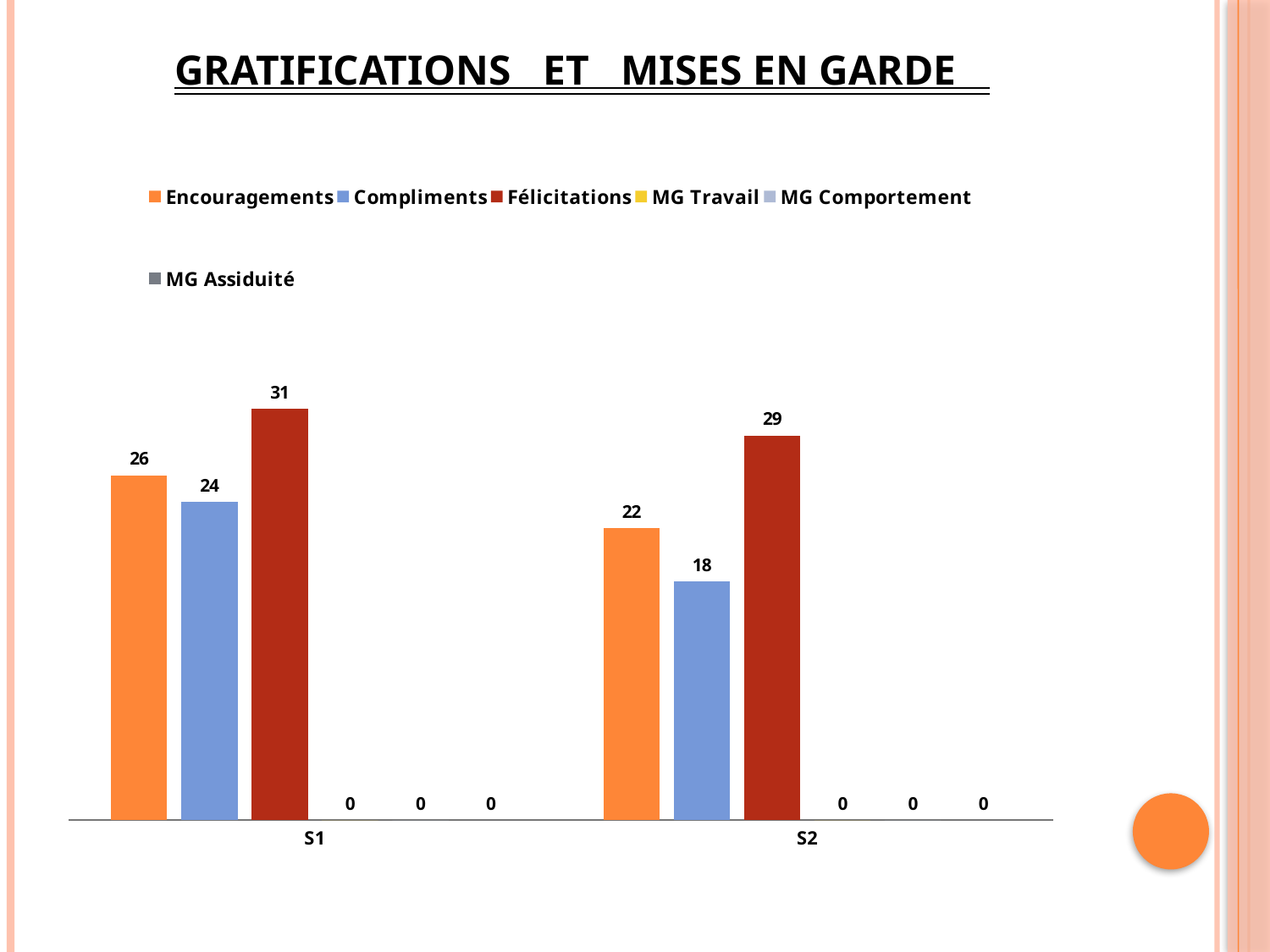
Which series has the highest value in S1? Félicitations What is the difference between Encouragements in S1 and Encouragements in S2? 4 What is the difference between Félicitations and Compliments in S2? 11 What is the value for Compliments in S2? 18 Which is larger: Compliments in S1 or Encouragements in S2? Compliments in S1 Which of the three non-zero series has the lowest value in S2? Compliments What is the value for Félicitations in S1? 31 How many categories are shown on the x axis? 2 How many series does the legend list? 6 What kind of chart is shown on the slide? Bar chart What is the value for MG Travail in S1? 0 What is the value for Encouragements in S2? 22